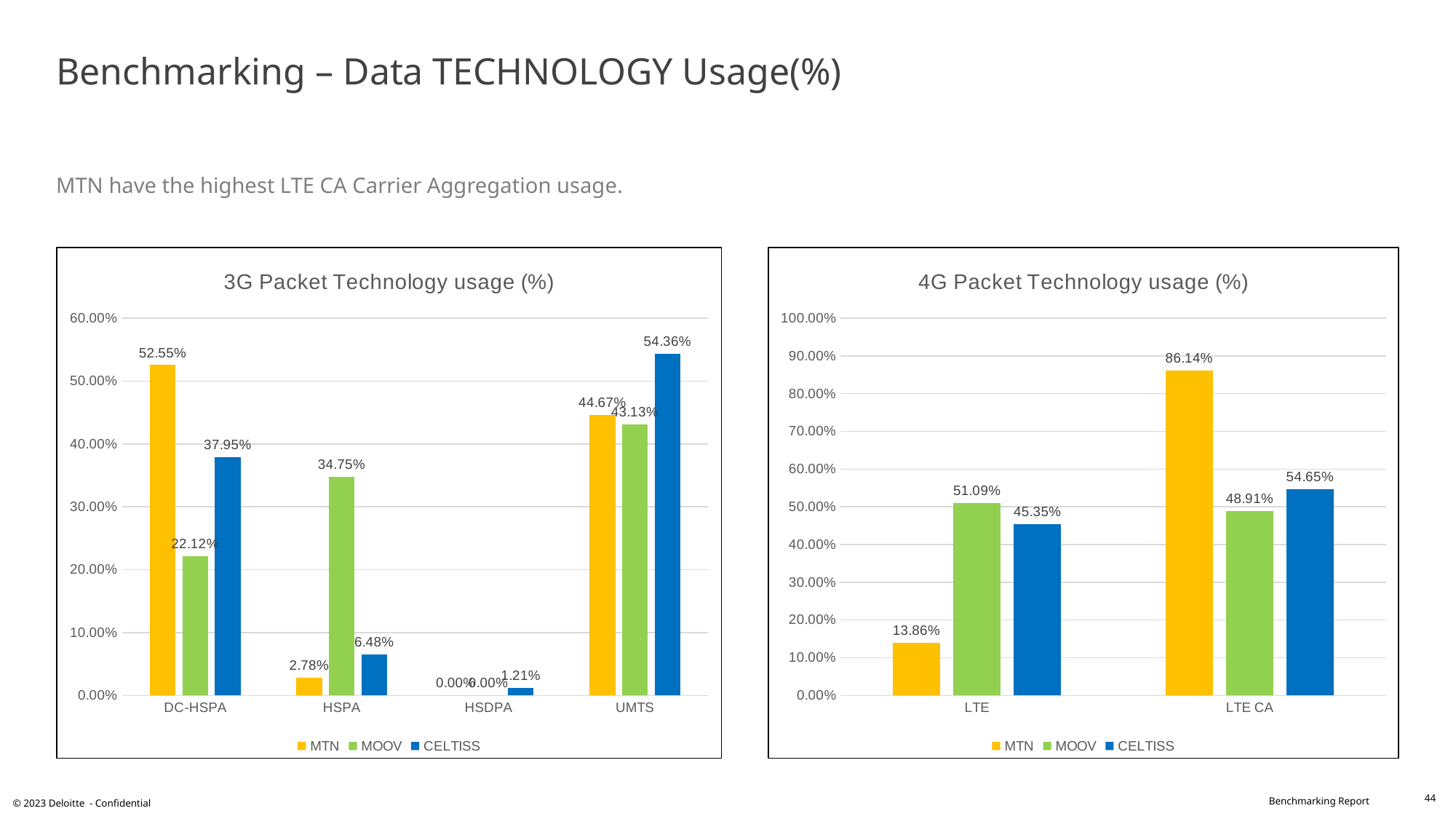
In the 3G Packet Technology usage (%) chart, what is the difference between the MTN and MOOV values for DC-HSPA? 30.43% In the 4G Packet Technology usage (%) chart, what is the MTN value for LTE CA? 86.14% In the 3G Packet Technology usage (%) chart, what is the MTN value for DC-HSPA? 52.55% In the 3G Packet Technology usage (%) chart, what is the MOOV value for HSPA? 34.75% What type of chart is the 3G Packet Technology usage (%) chart? Bar chart In the 4G Packet Technology usage (%) chart, what is the difference between the CELTISS and MOOV values for LTE CA? 5.74% In the 4G Packet Technology usage (%) chart, is the MOOV value for LTE larger or the CELTISS value for LTE? MOOV In the 4G Packet Technology usage (%) chart, which series has the lowest value for LTE? MTN In the 3G Packet Technology usage (%) chart, how many categories are shown on the x axis? 4 In the 3G Packet Technology usage (%) chart, which series has the highest value for UMTS? CELTISS In the 3G Packet Technology usage (%) chart, what is the CELTISS value for HSDPA? 1.21% How many series does the legend of the 4G Packet Technology usage (%) chart list? 3